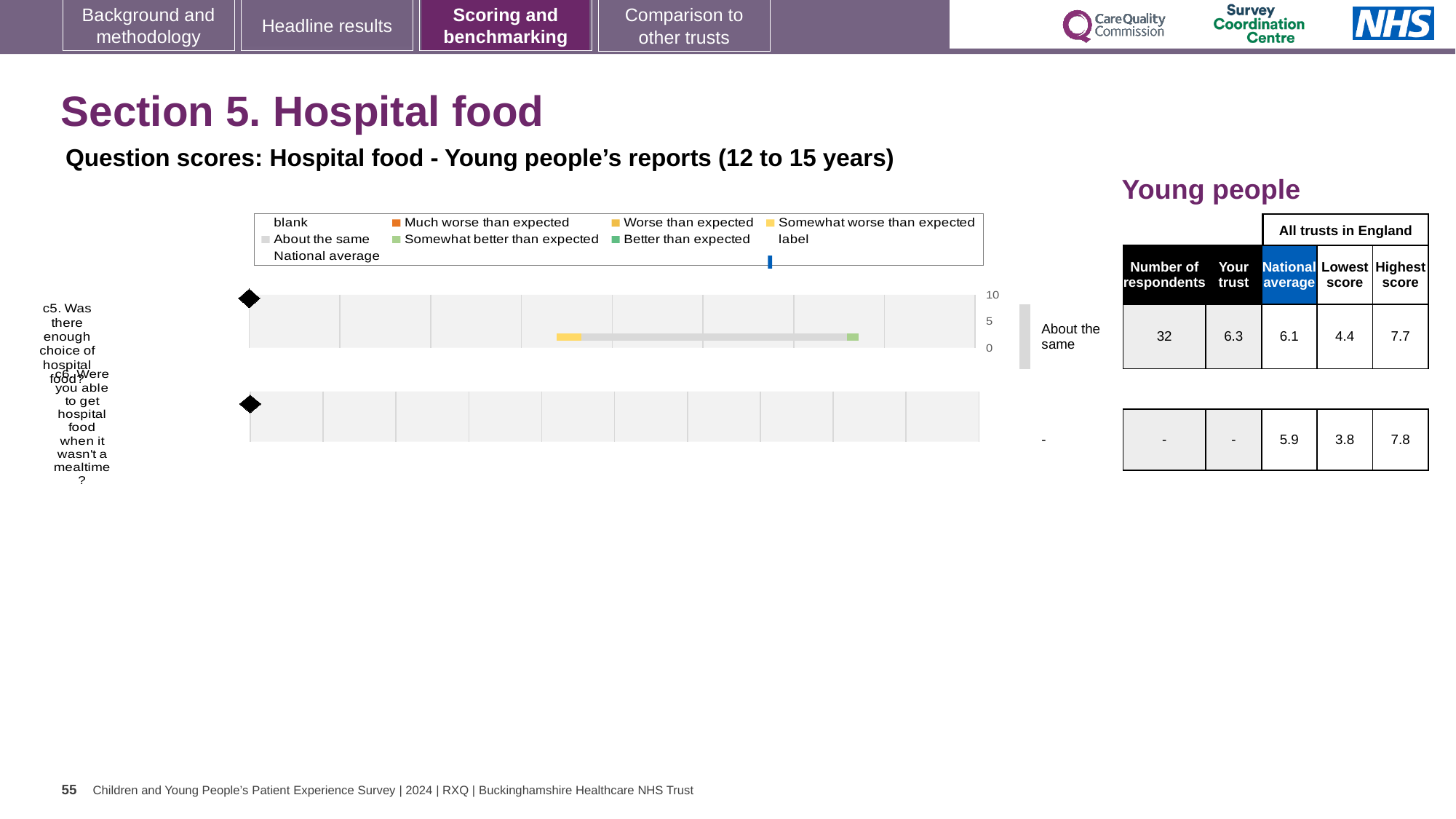
For question c5, which is higher: the 'Your trust' score or the national average? Your trust What is the highest score across all trusts in England for question c6 (Were you able to get hospital food when it wasn't a mealtime?)? 7.8 For question c5, what is the difference between the highest score (7.7) and the lowest score (4.4) across all trusts in England? 3.3 How many survey questions are plotted in the chart on this slide? 2 What kind of chart is used on this slide to show the question scores? Bar chart What is the national average score for question c5 shown on the slide? 6.1 What is the national average score for question c6 shown on the slide? 5.9 What is the lowest score across all trusts in England for question c5? 4.4 What benchmark category is shown next to the chart for question c5? About the same How many respondents answered question c5 according to the table on the slide? 32 What is the 'Your trust' score for question c5 (Was there enough choice of hospital food?) shown in the table next to the chart? 6.3 For question c5, how much higher is the 'Your trust' score than the national average? 0.2